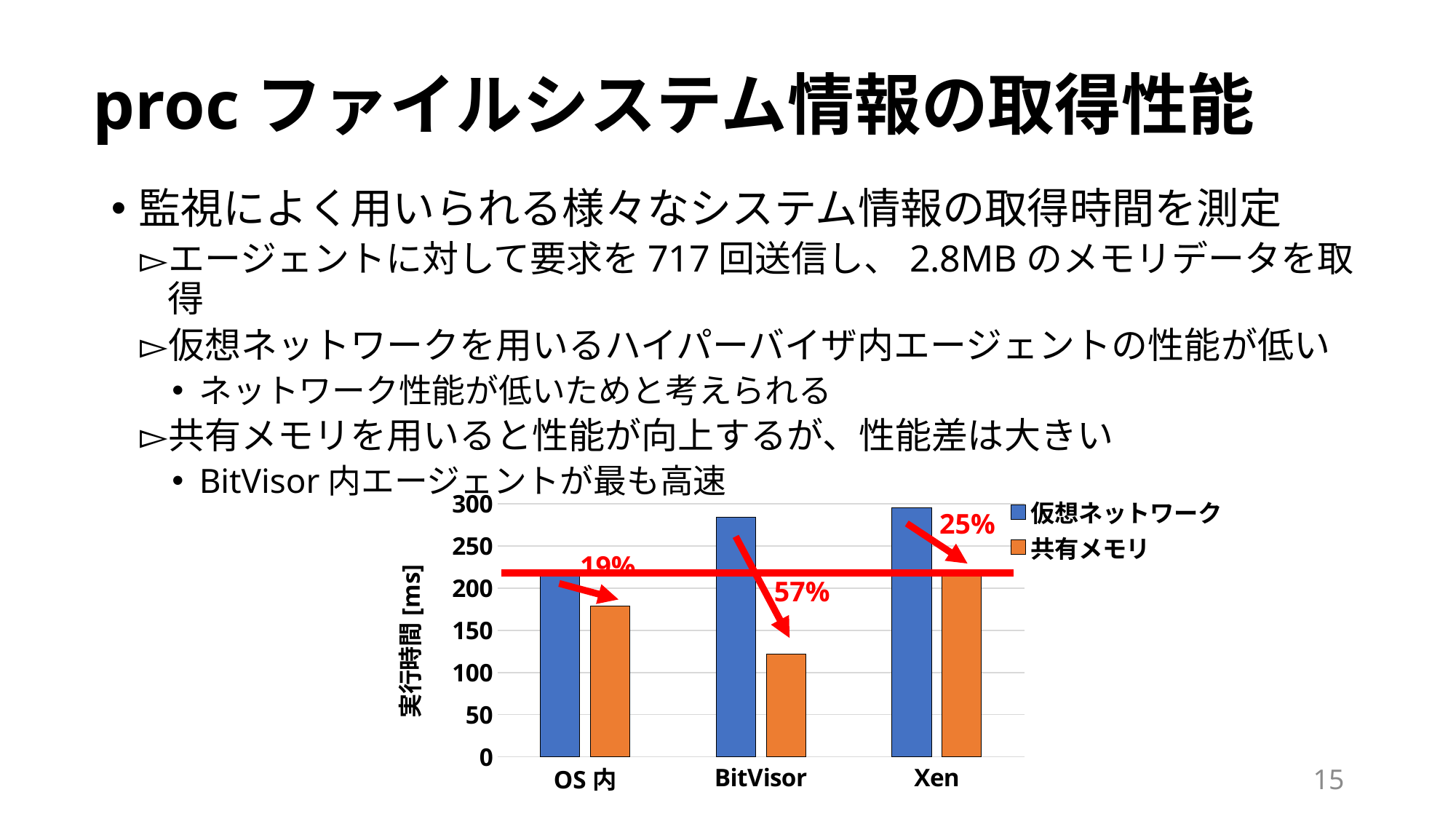
Which category has the highest 共有メモリ value? Xen For OS 内, which is larger: the 仮想ネットワーク value or the 共有メモリ value? 仮想ネットワーク How many series does the chart legend list? 2 What kind of chart is shown on the slide? bar chart How many categories are shown on the x axis of the chart? 3 What percentage reduction is annotated above the BitVisor bars? 57% Is the 仮想ネットワーク value for Xen greater or less than 250? greater Is the 仮想ネットワーク value for OS 内 greater or less than 250? less Which category has the lowest 共有メモリ value? BitVisor What is the label of the y axis of the chart? 実行時間 [ms] Is the 共有メモリ value for BitVisor greater or less than 150? less